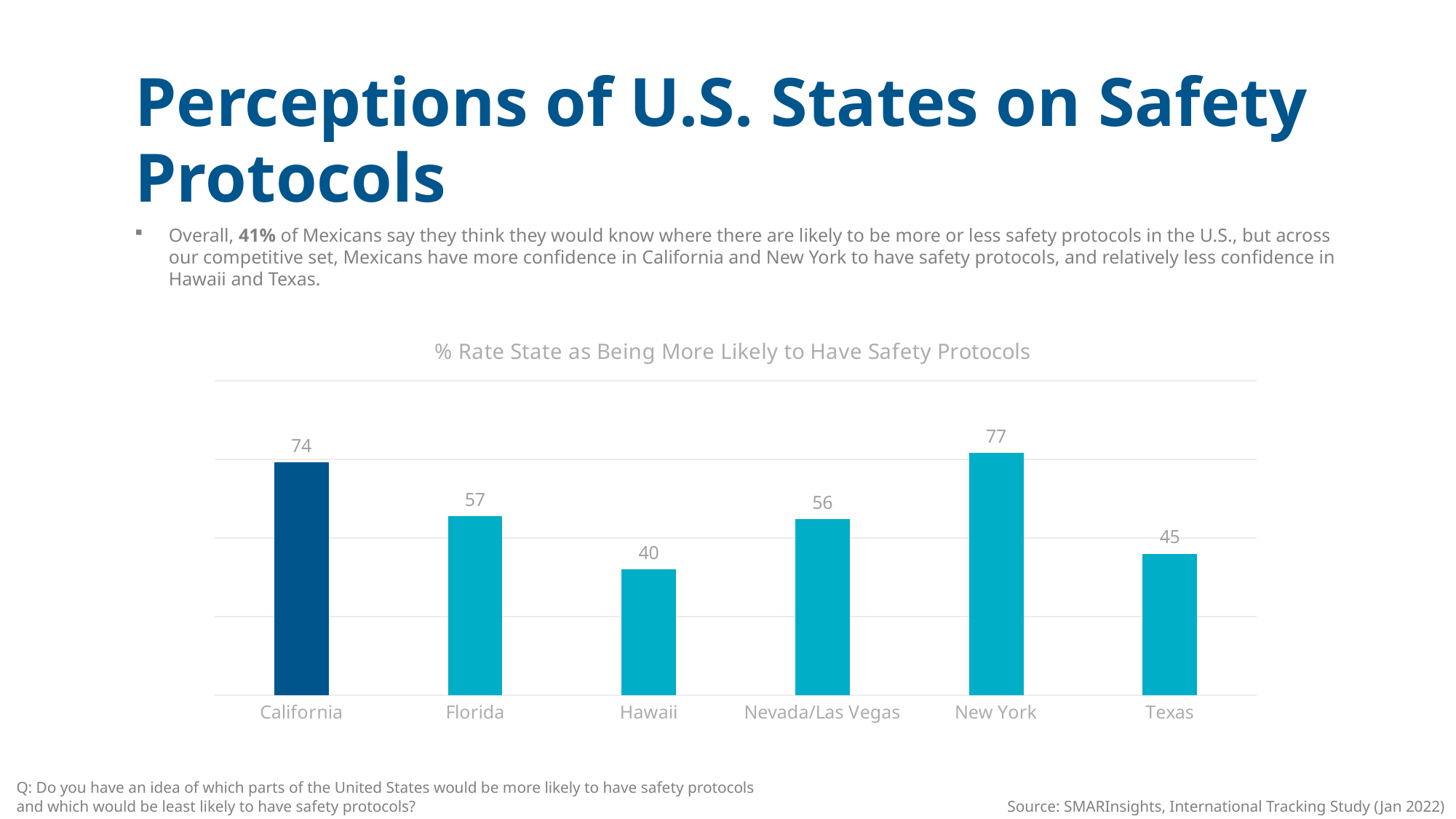
What is the value for California? 74 How many states are shown in the chart? 6 What kind of chart is shown on the slide? Bar chart What is the title of the chart? % Rate State as Being More Likely to Have Safety Protocols What is the difference between the values for Florida and Texas? 12 Which has a larger value, Hawaii or Nevada/Las Vegas? Nevada/Las Vegas Which has a larger value, Florida or Texas? Florida Which state has the highest value? New York What is the value for Nevada/Las Vegas? 56 What is the difference between the values for New York and California? 3 What is the value for Hawaii? 40 Which state has the lowest value? Hawaii